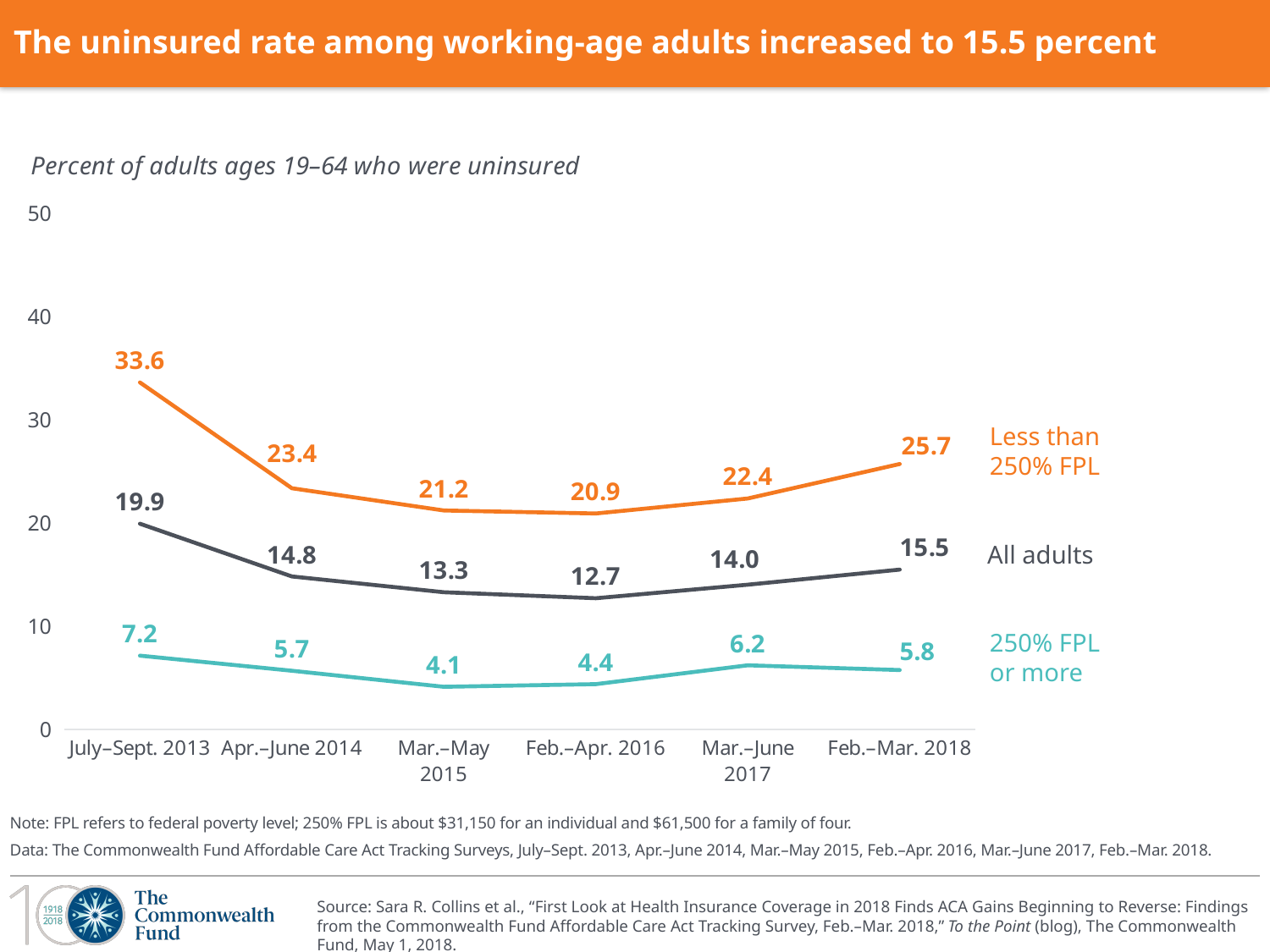
By how much did the uninsured rate for all adults fall from July–Sept. 2013 to Feb.–Apr. 2016? 7.2 Which was higher for adults at 250% FPL or more: the rate in Mar.–June 2017 or in Feb.–Mar. 2018? Mar.–June 2017 How many lines (series) are plotted on the chart? 3 What was the uninsured rate for adults at 250% FPL or more in Mar.–May 2015? 4.1 How many survey periods are shown on the x axis? 6 How did the uninsured rate for all adults change from Feb.–Apr. 2016 to Feb.–Mar. 2018? It rose What was the uninsured rate for adults with incomes less than 250% FPL in July–Sept. 2013? 33.6 What is the difference between the uninsured rate for adults with incomes less than 250% FPL and for all adults in Feb.–Mar. 2018? 10.2 What type of chart is shown on the slide? Line chart What was the uninsured rate for all adults in Feb.–Mar. 2018? 15.5 In which survey period was the uninsured rate for adults with incomes less than 250% FPL highest? July–Sept. 2013 In which survey period was the uninsured rate for all adults lowest? Feb.–Apr. 2016